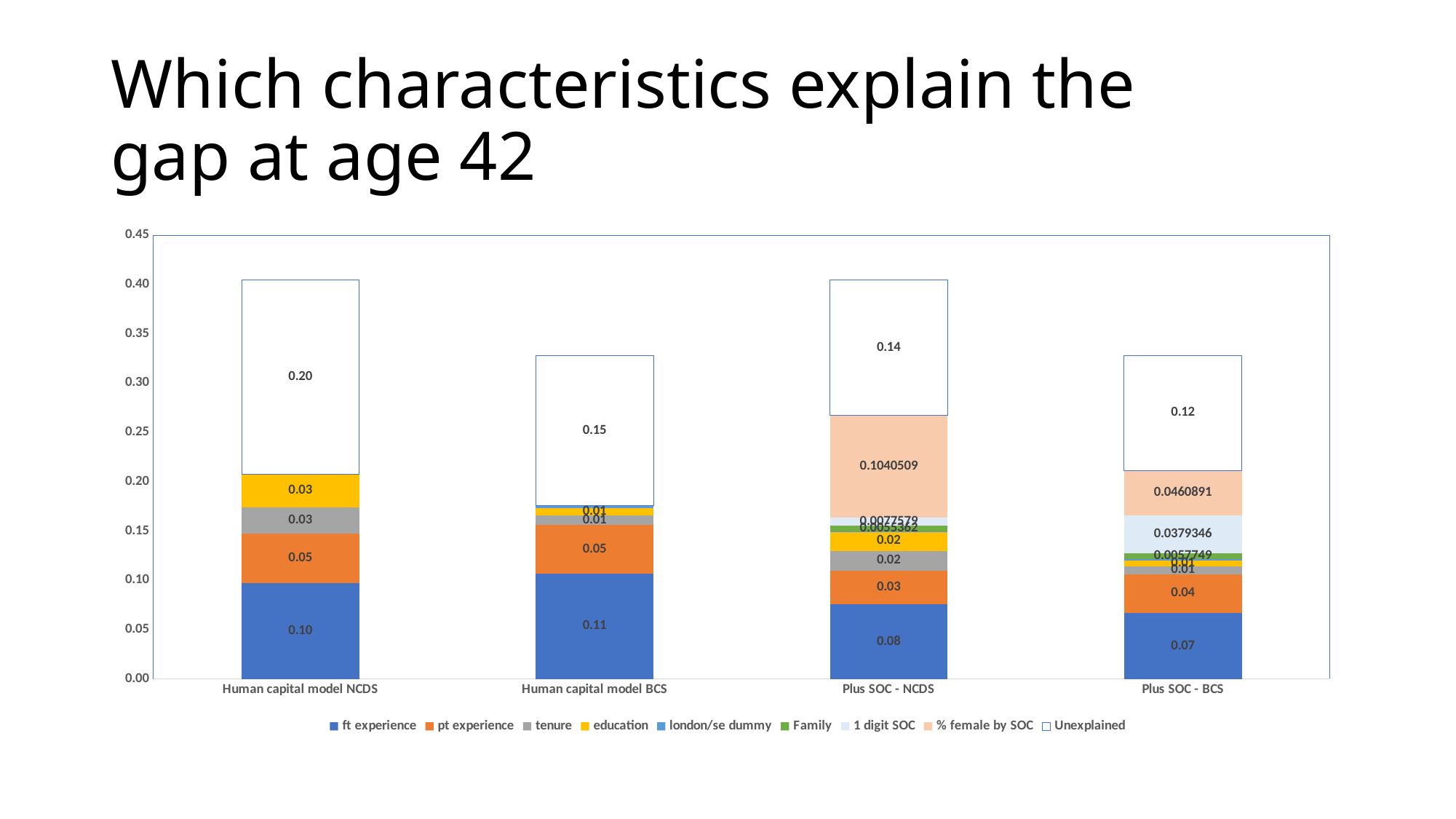
What is the difference between the Unexplained values for Human capital model NCDS and Human capital model BCS? 0.05 Is the total height of the Plus SOC - BCS bar greater or less than 0.30? greater What is the 1 digit SOC value for Plus SOC - BCS? 0.0379346 What kind of chart is shown on the slide? stacked bar chart What is the ft experience value for Human capital model BCS? 0.11 What is the % female by SOC value for Plus SOC - NCDS? 0.1040509 Which is larger, the pt experience value for Plus SOC - NCDS or for Plus SOC - BCS? Plus SOC - BCS Which category has the highest Unexplained value? Human capital model NCDS How many series does the legend list? 9 What is the Unexplained value for Human capital model NCDS? 0.20 How many categories are shown along the x axis? 4 Which category has the lowest ft experience value? Plus SOC - BCS